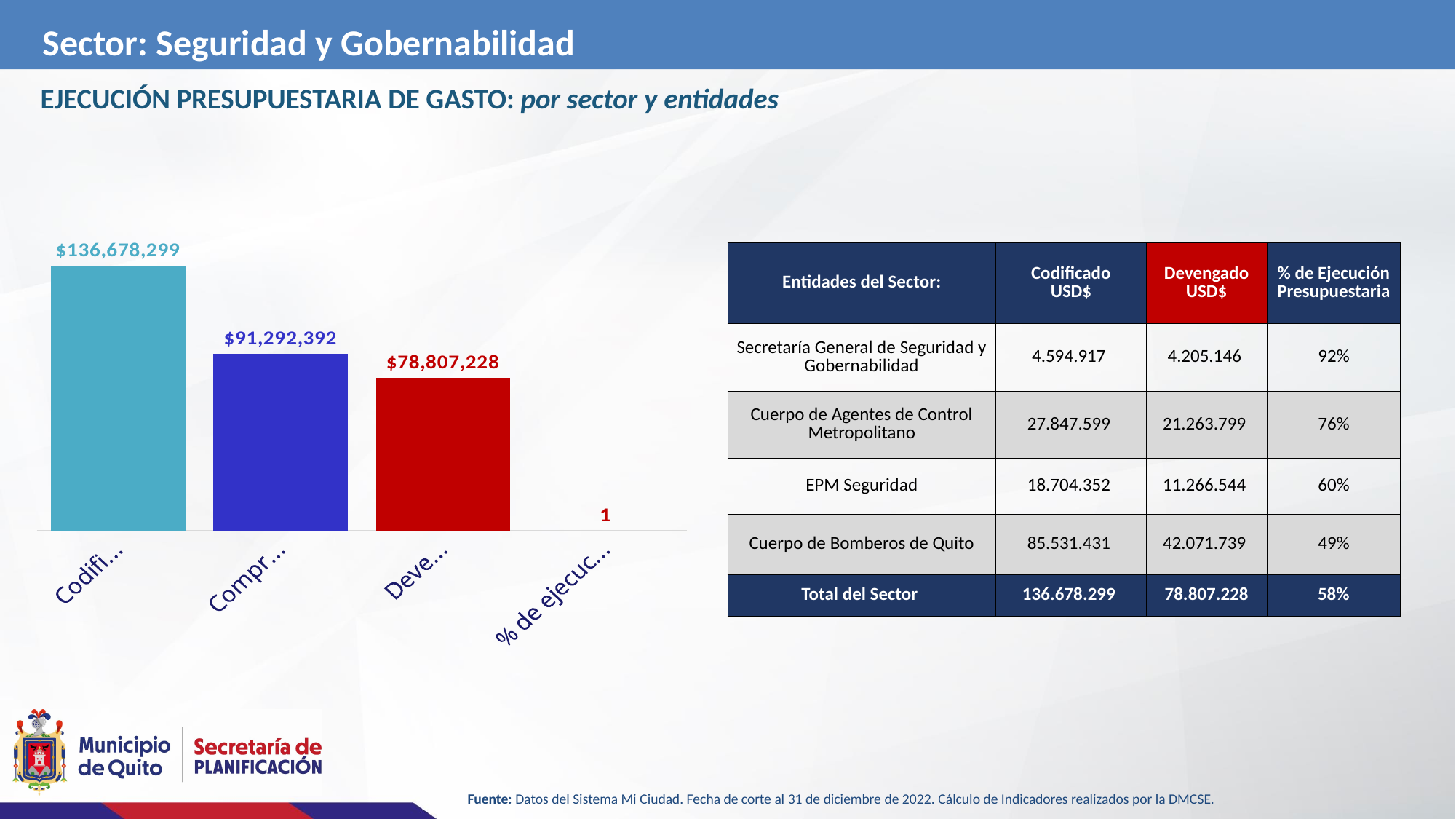
What is the difference between the second bar ($91,292,392) and the third bar ($78,807,228)? $12,485,164 What is the value shown on the second bar, labelled "Compr..."? $91,292,392 What is the value shown on the first (leftmost) bar, labelled "Codifi..."? $136,678,299 What is the value shown on the third bar, labelled "Deve..."? $78,807,228 What is the difference between the first bar ($136,678,299) and the third bar ($78,807,228)? $57,871,071 Which is larger, the value of the "Compr..." bar or the "Deve..." bar? Compr... ($91,292,392) Which bar in the chart has the highest value? Codifi... ($136,678,299) What kind of chart is shown on the left of the slide? bar chart How many bars/categories does the bar chart show? 4 Do the bar values rise or fall from left to right across the chart? fall What value is printed above the fourth category, labelled "% de ejecuc..."? 1 Which category in the chart has the lowest value? % de ejecuc... (1)